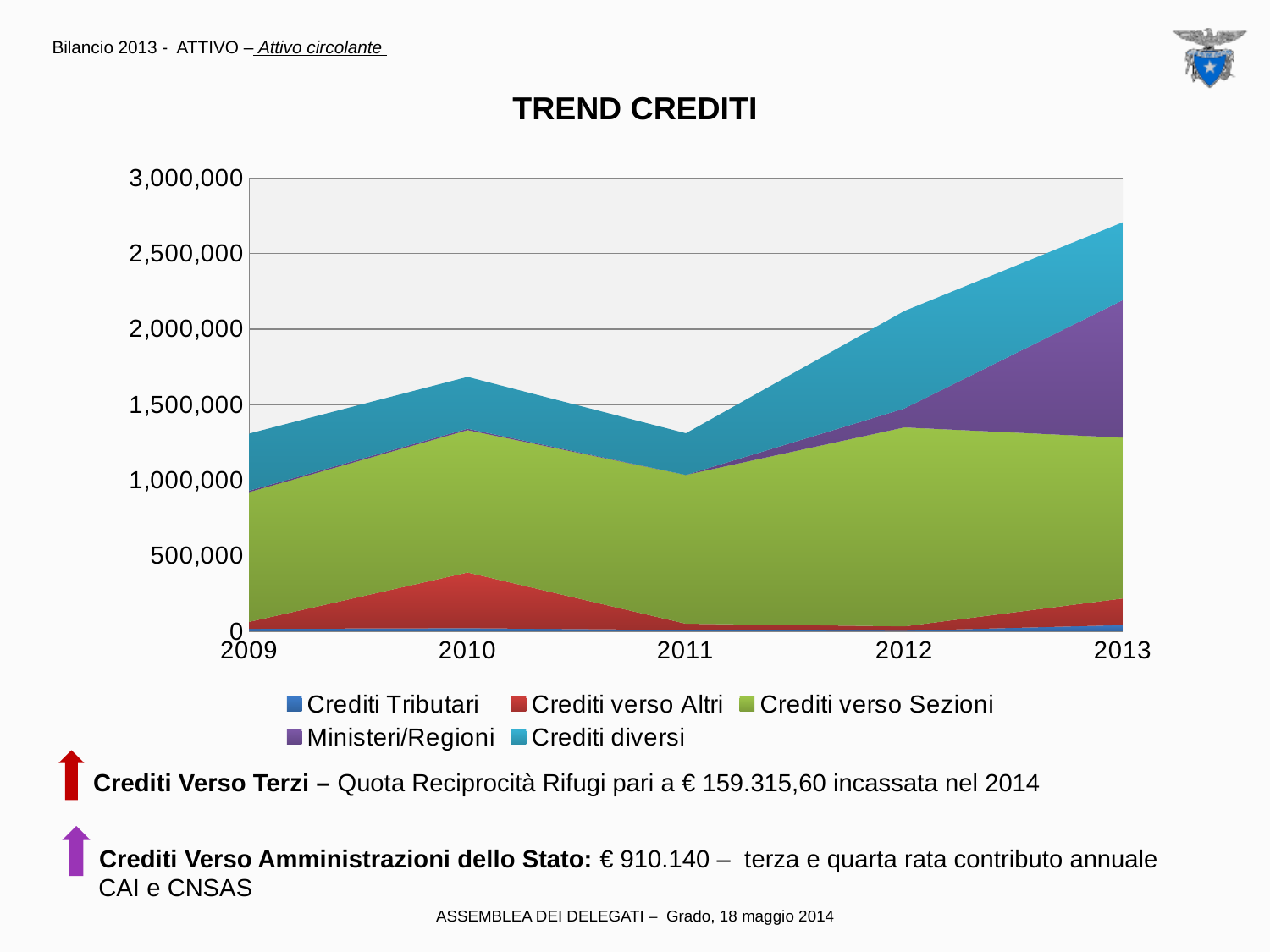
What is the title of the chart? TREND CREDITI Is the total value for 2012 greater or less than 2,000,000? greater What kind of chart is shown on the slide? Stacked area chart Is the total value for 2013 greater or less than 2,500,000? greater Is the total value for 2009 greater or less than 1,500,000? less Which series is listed first in the legend? Crediti Tributari How many years are shown on the x axis? 5 Which year has the highest total crediti? 2013 In which year is the Ministeri/Regioni series largest? 2013 Does the total value rise or fall from 2011 to 2013? rise How many series does the legend list? 5